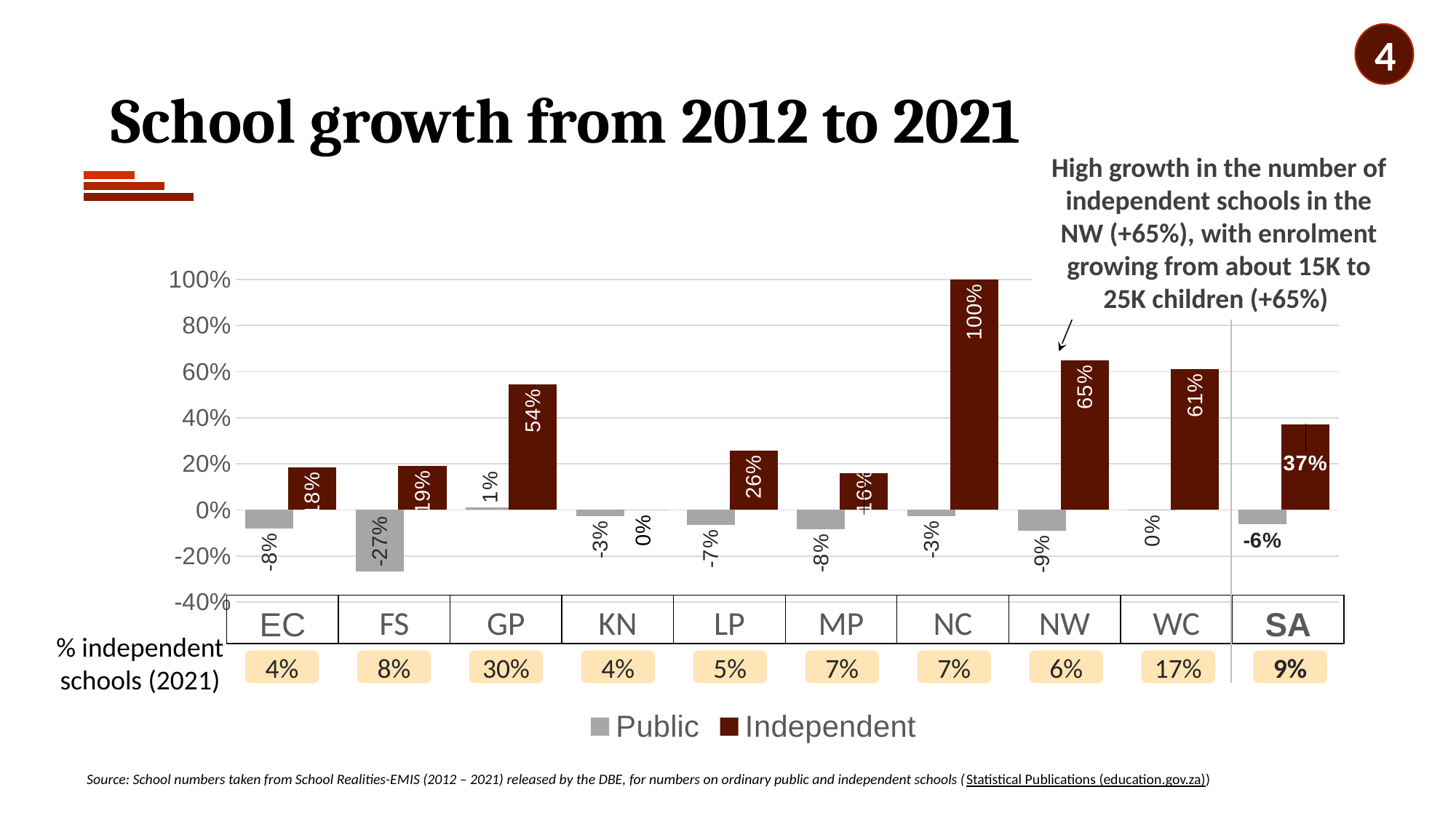
What is the difference between the Independent growth for GP and for FS? 35 percentage points How many series does the legend list? 2 Which is larger, the Independent growth for GP or for LP? GP What kind of chart is shown on the slide? Bar chart How many categories are shown on the x axis? 10 What is the Public school growth value for WC? 0% What is the Independent school growth value for SA? 37% Which province has the lowest Public school growth? FS Which province has the highest Independent school growth? NC What is the Public school growth value for FS? -27% What is the % independent schools (2021) value shown for GP? 30% What is the Independent school growth value for NC? 100%